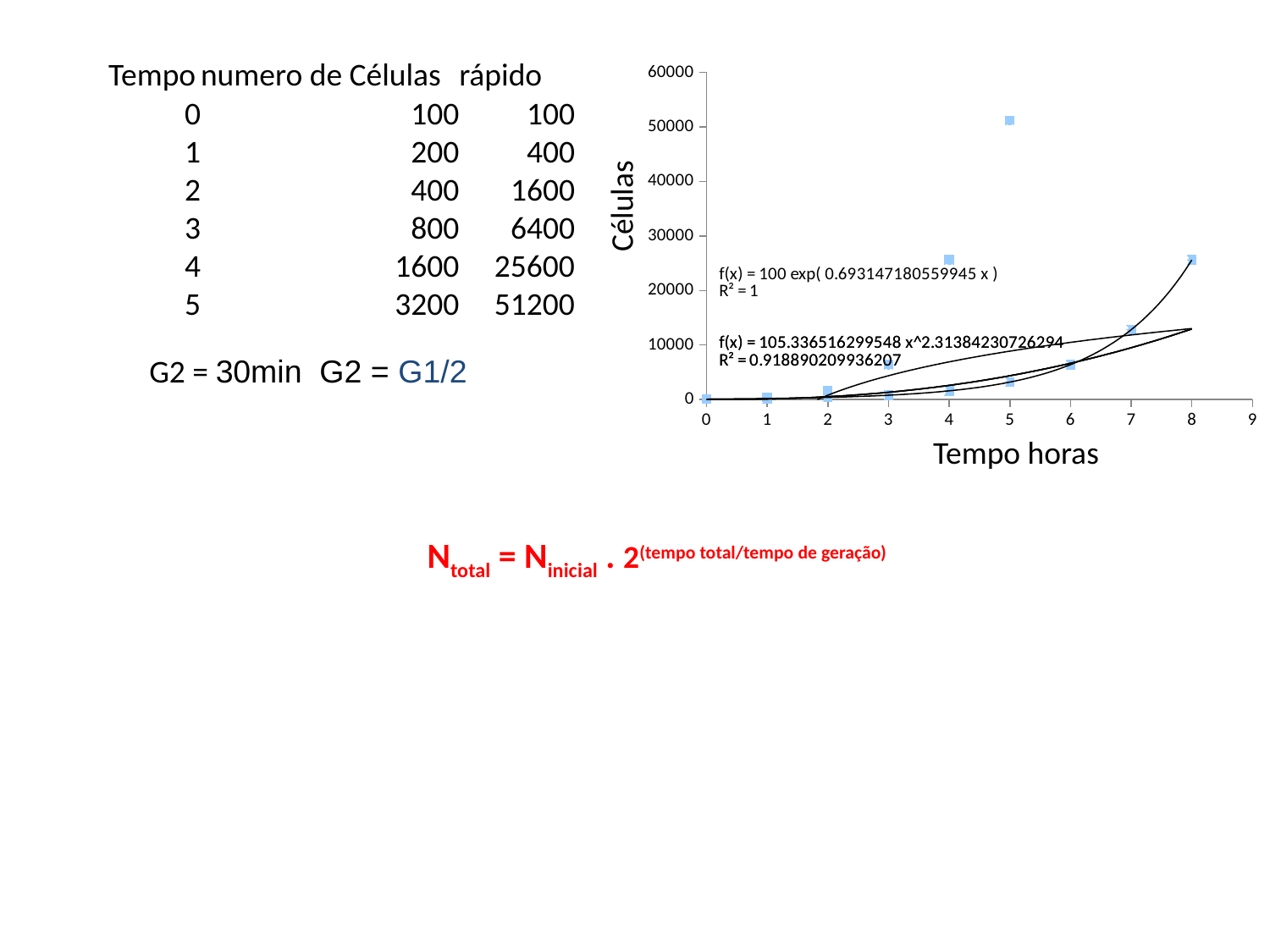
Is the plotted point at Tempo horas = 2 greater or less than 10000 Células? less What is the title of the horizontal axis of the chart? Tempo horas Is the plotted point at Tempo horas = 8 greater or less than 20000 Células? greater What is the title of the vertical axis of the chart? Células Is the highest plotted point at Tempo horas = 4 greater or less than 20000 Células? greater What is the maximum value shown on the vertical axis of the chart? 60000 What kind of chart is shown on the slide? scatter chart Do the plotted Células values generally rise or fall as Tempo horas increases? rise At which Tempo horas value is the highest plotted point located? 5